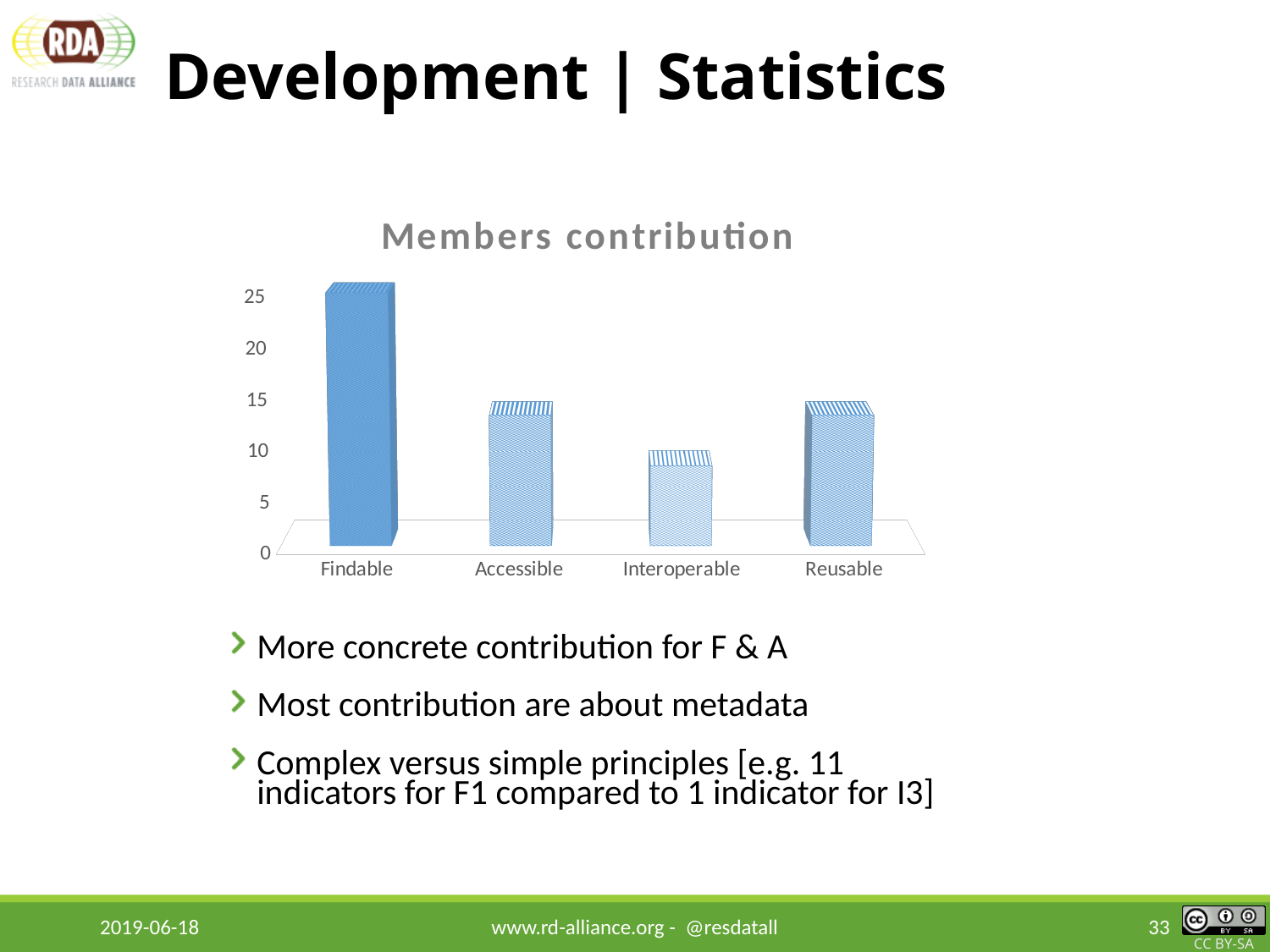
Is the value for Reusable greater or less than 20? less Is the value for Interoperable greater or less than 15? less What is the title of the chart? Members contribution Which category has the highest value in the chart? Findable Is the value for Findable greater or less than 20? greater Which is larger, the value for Interoperable or the value for Reusable? Reusable How many categories are shown on the x axis of the chart? 4 What kind of chart is shown on the slide? bar chart What is the label of the third category on the x axis? Interoperable Which category has the lowest value in the chart? Interoperable Which is larger, the value for Findable or the value for Accessible? Findable